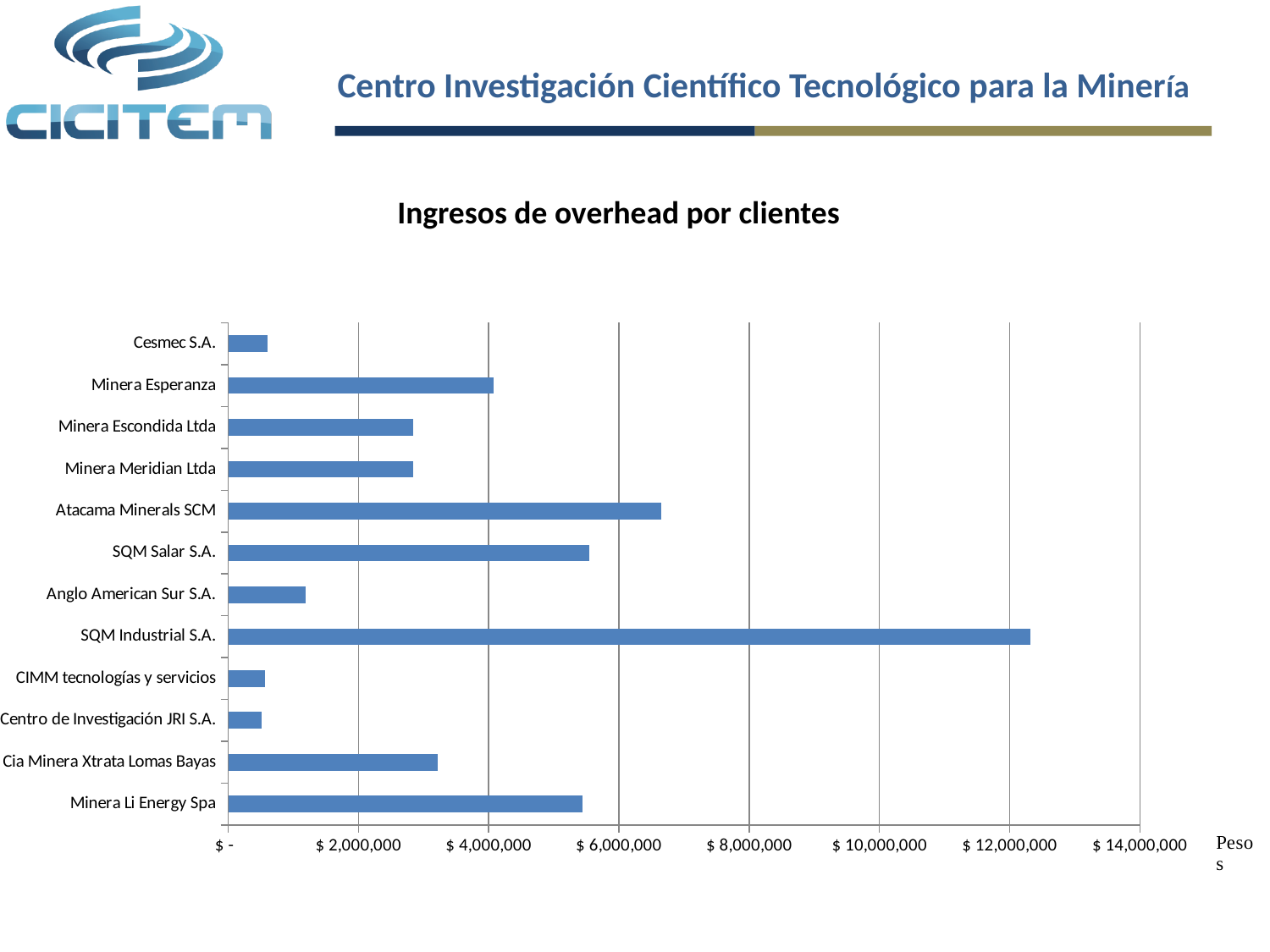
Which client has the highest overhead income? SQM Industrial S.A. What is the title of the chart? Ingresos de overhead por clientes Which has a larger value, Minera Esperanza or Cia Minera Xtrata Lomas Bayas? Minera Esperanza Is the value for Atacama Minerals SCM greater or less than $6,000,000? greater Is the value for SQM Industrial S.A. greater or less than $12,000,000? greater Is the value for Cia Minera Xtrata Lomas Bayas greater or less than $4,000,000? less What unit label is shown at the end of the horizontal axis? Pesos How many clients (categories) are shown in the chart? 12 What kind of chart is shown on the slide? bar chart Which has a larger value, Atacama Minerals SCM or SQM Salar S.A.? Atacama Minerals SCM